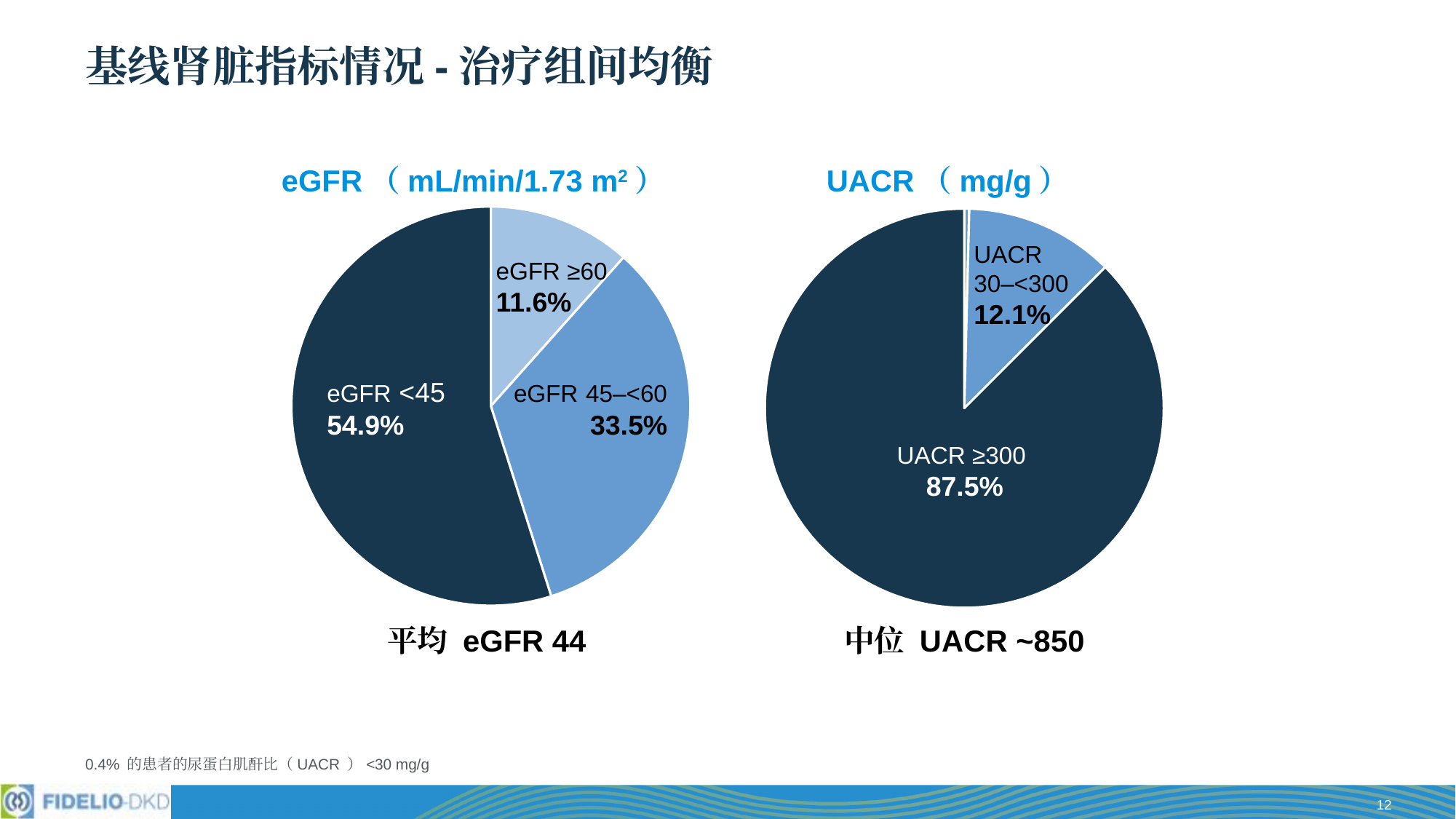
In the eGFR pie chart, which category has the largest share? eGFR <45 What type of chart is used on this slide to show the eGFR and UACR distributions? Pie chart How many labeled categories does the eGFR pie chart show? 3 In the eGFR pie chart, what is the difference in percentage points between the eGFR <45 and eGFR 45–<60 shares? 21.4 In the eGFR pie chart, what share of patients have eGFR 45–<60? 33.5% In the eGFR pie chart, what share of patients have eGFR ≥60? 11.6% In the eGFR pie chart, what share of patients have eGFR <45? 54.9% In the UACR pie chart, what share of patients have UACR ≥300? 87.5% In the UACR pie chart, what share of patients have UACR 30–<300? 12.1% In the UACR pie chart, what is the difference in percentage points between the UACR ≥300 and UACR 30–<300 shares? 75.4 Which is larger in the eGFR pie chart: the share for eGFR 45–<60 or the share for eGFR ≥60? eGFR 45–<60 In the eGFR pie chart, which category has the smallest share? eGFR ≥60